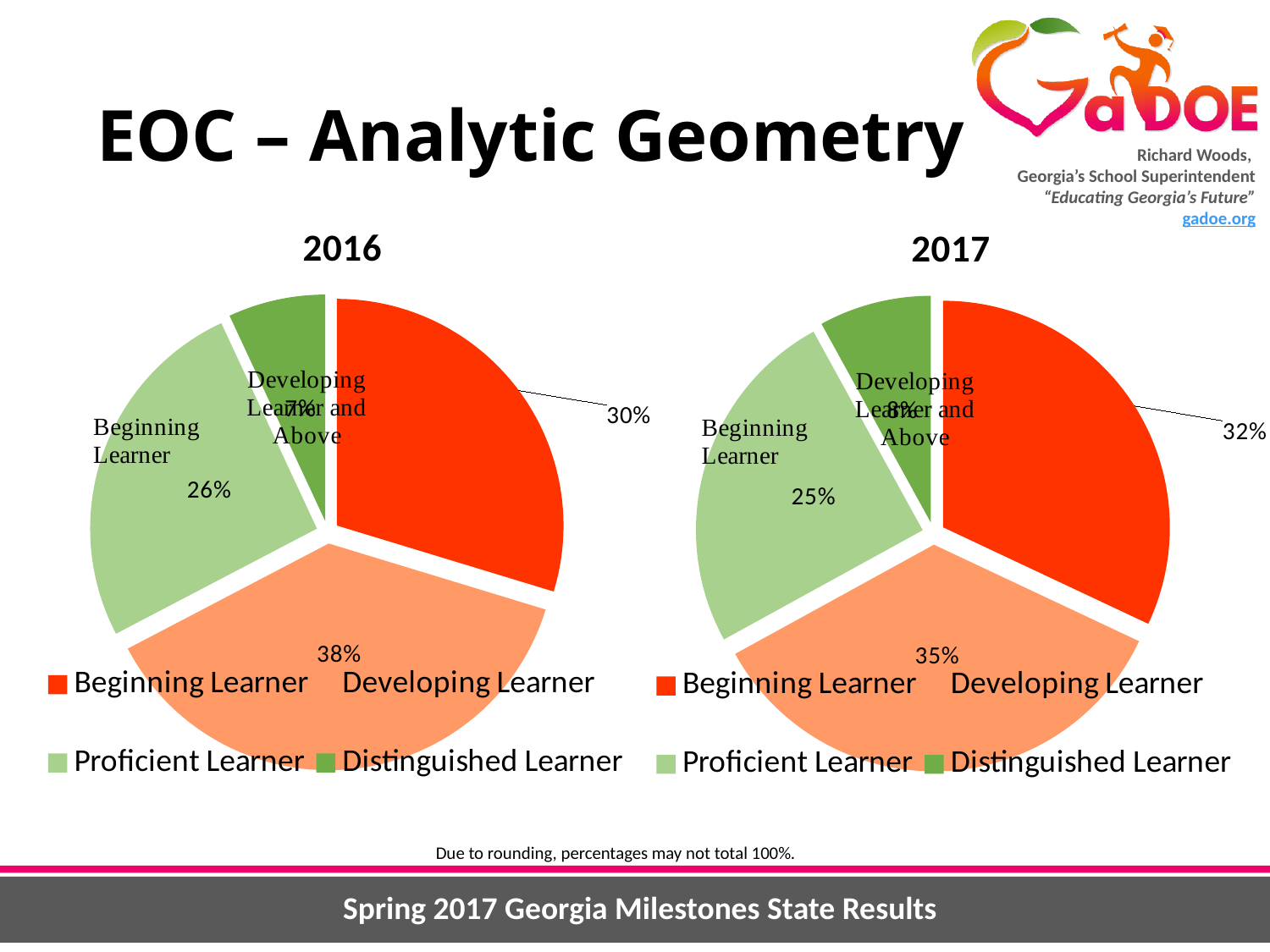
Is the Beginning Learner slice larger in the 2016 chart or the 2017 chart? 2017 In the 2017 chart, which category has the smallest slice? Distinguished Learner In the 2016 chart, what percentage is shown for Beginning Learner? 30% In the 2016 chart, which category has the largest slice? Developing Learner What is the difference between the Developing Learner percentages in the 2016 and 2017 charts? 3% What colour represents Beginning Learner in the legend? Red How many categories does the legend of the 2017 chart list? 4 What type of chart is used for the 2016 data? Pie chart In the 2017 chart, what percentage is shown for Beginning Learner? 32% In the 2017 chart, what percentage is shown for Proficient Learner? 25% In the 2016 chart, what percentage is shown for Developing Learner? 38% In the 2016 chart, which is larger: Beginning Learner or Proficient Learner? Beginning Learner